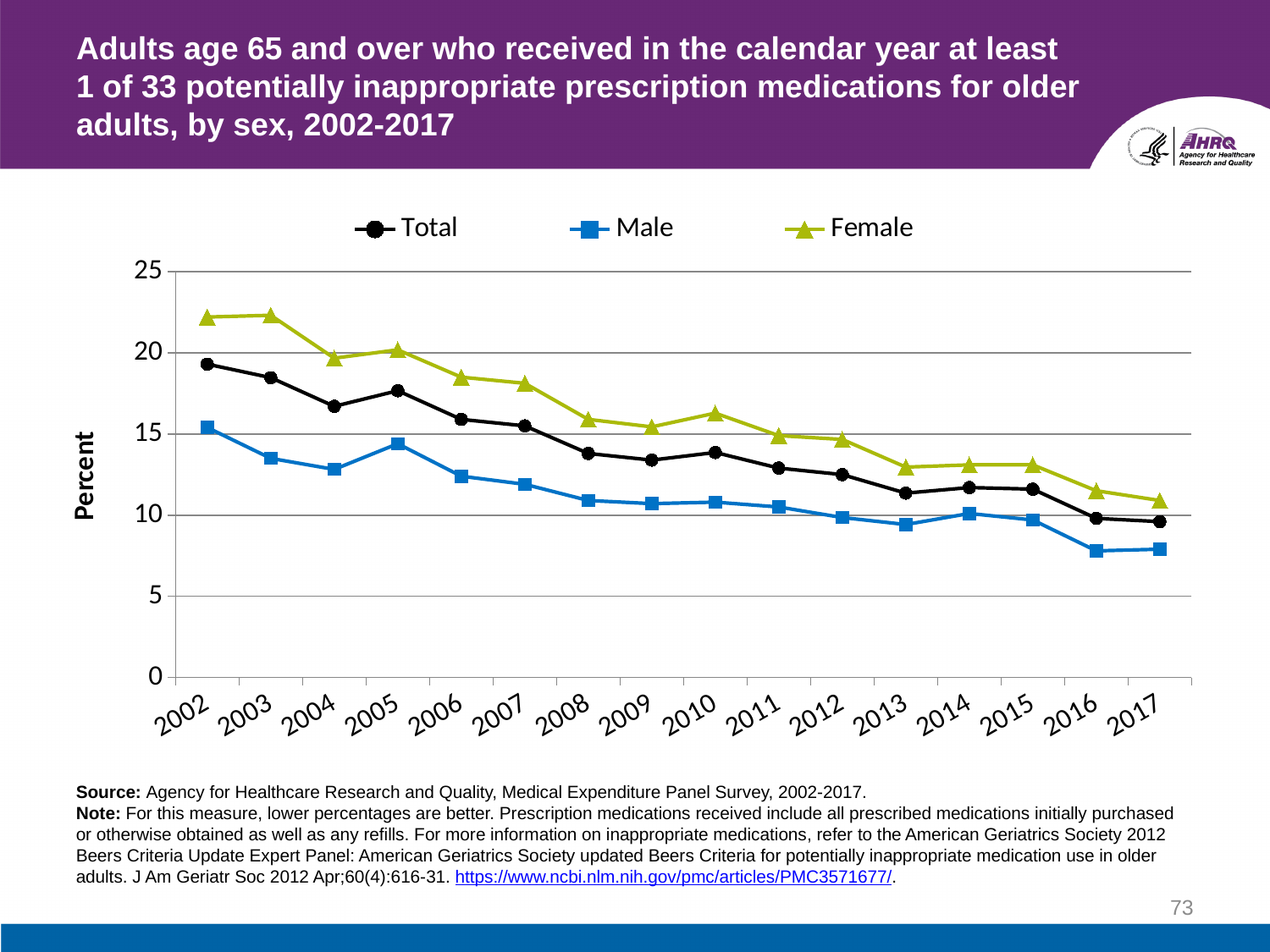
In which year is the Female series at its lowest? 2017 How many years are plotted along the x axis? 16 In which year is the Male series at its highest? 2002 Is the value for Male in 2017 greater or less than 10? less What kind of chart is shown on the slide? line chart What is the label on the y axis? Percent Do the values for the Total series rise or fall from 2002 to 2017? fall Is the value for Total in 2008 greater or less than 15? less Is the value for Female in 2002 greater or less than 20? greater How many series does the legend list? 3 In 2010, which is larger, the value for Female or the value for Male? Female